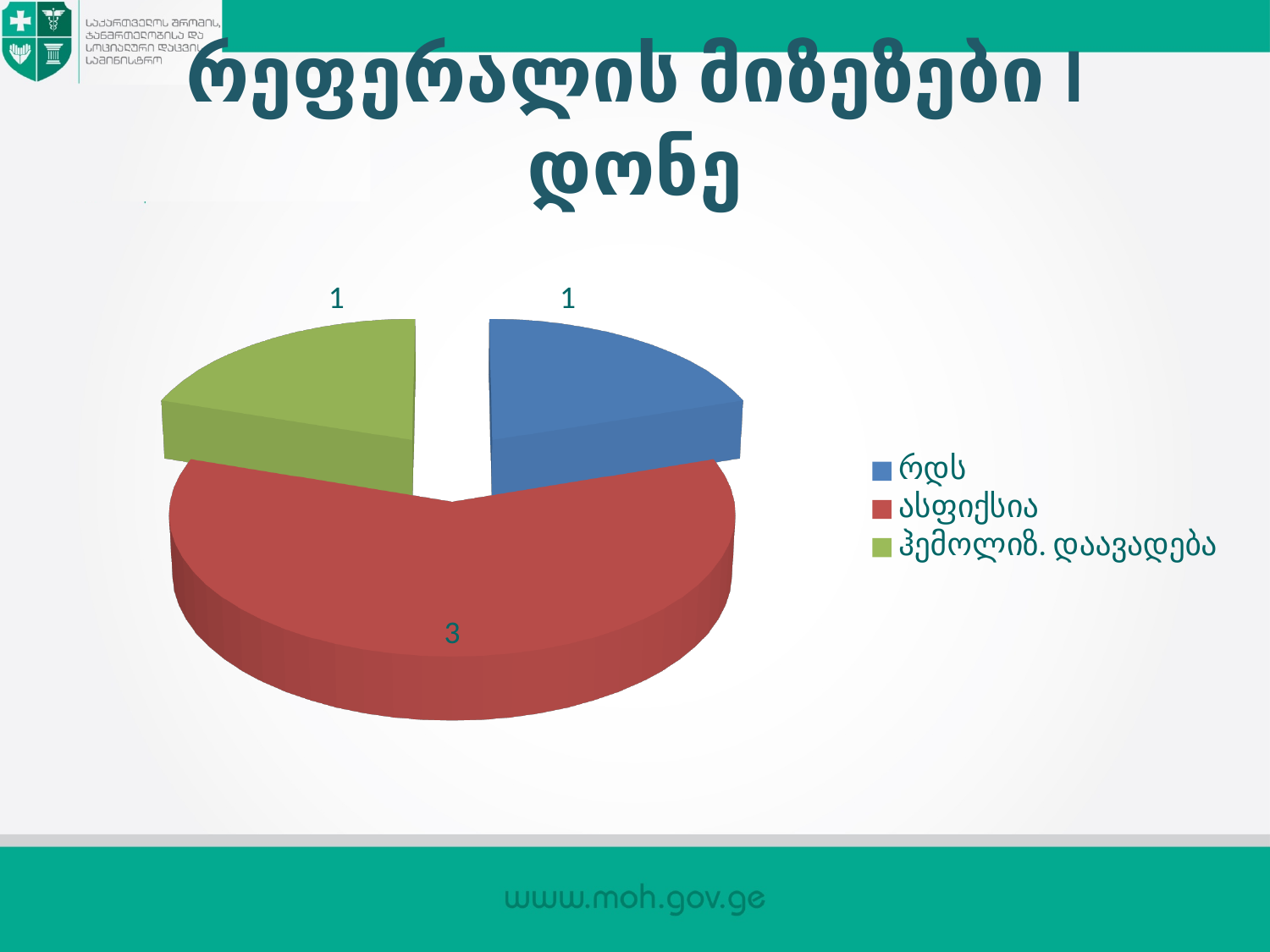
What colour is the slice for ასფიქსია? red How many categories does the pie chart show? 3 Which is larger, the value for ასფიქსია or the value for ჰემოლიზ. დაავადება? ასფიქსია What is the difference between the value for ასფიქსია and the value for რდს? 2 How many entries does the legend list? 3 What kind of chart is shown on the slide? pie chart What share of the pie does ასფიქსია represent? 60% What is the value for ასფიქსია in the pie chart? 3 What is the value for რდს in the pie chart? 1 What is the total of all slices in the pie chart? 5 Which category has the largest slice in the pie chart? ასფიქსია What is the value for ჰემოლიზ. დაავადება in the pie chart? 1